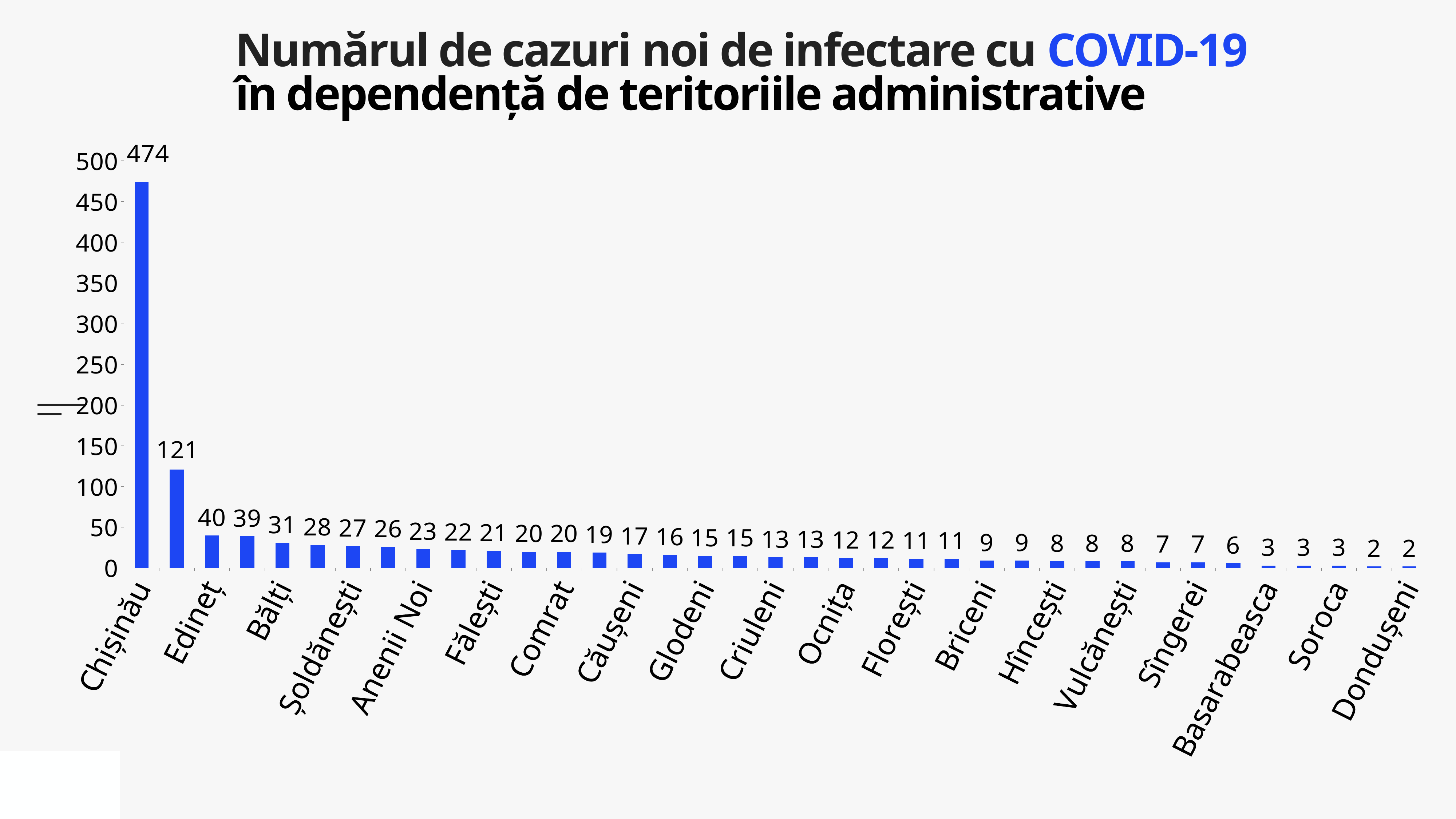
Which territory has the highest number of new cases? Chișinău What is the difference between the values for Chișinău and Dondușeni? 472 Do the values rise or fall from left to right along the x axis? fall What is the value for Bălți? 31 What is the value for Edineț? 40 What is the value for Chișinău? 474 Is the value for Chișinău greater or less than 450? greater What kind of chart is shown on the slide? bar chart What colour are the bars in the chart? blue What is the value for Dondușeni? 2 Which is larger, the value for Chișinău or the value for Edineț? Chișinău What is the highest value shown on the vertical axis? 500